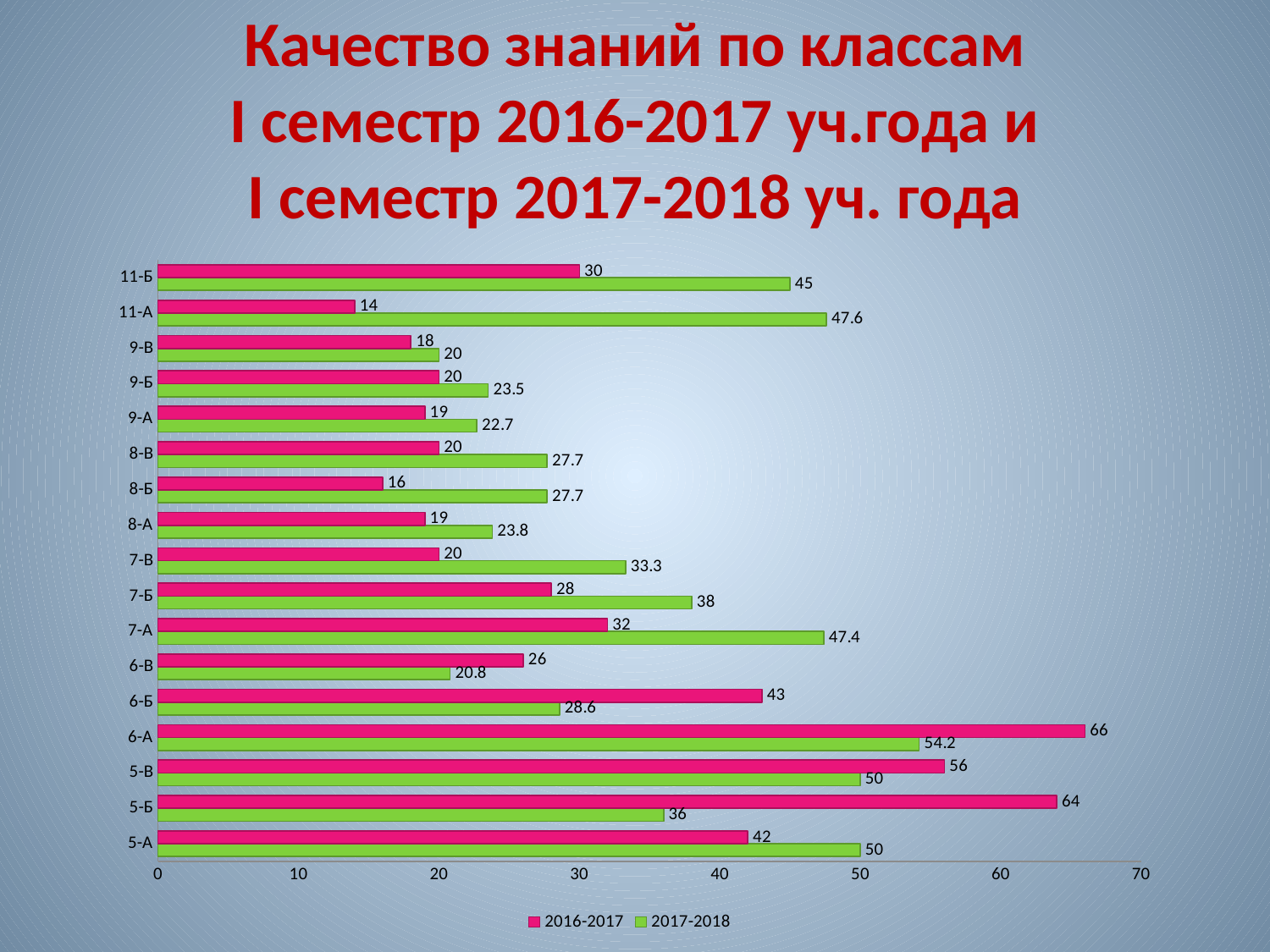
Which class has the lowest value in the 2016-2017 series? 11-А Which class has the highest value in the 2016-2017 series? 6-А What is the value for 11-А in the 2017-2018 series? 47.6 How many classes (categories) are shown on the chart? 17 What is the value for 5-Б in the 2016-2017 series? 64 How many series does the legend list? 2 What is the difference between the 2016-2017 and 2017-2018 values for 5-Б? 28 What is the difference between the 2017-2018 and 2016-2017 values for 11-Б? 15 For 7-А, which series has the larger value, 2016-2017 or 2017-2018? 2017-2018 Which colour represents the 2017-2018 series in the legend? green Which class has the lowest value in the 2017-2018 series? 9-В What type of chart is shown on the slide? bar chart